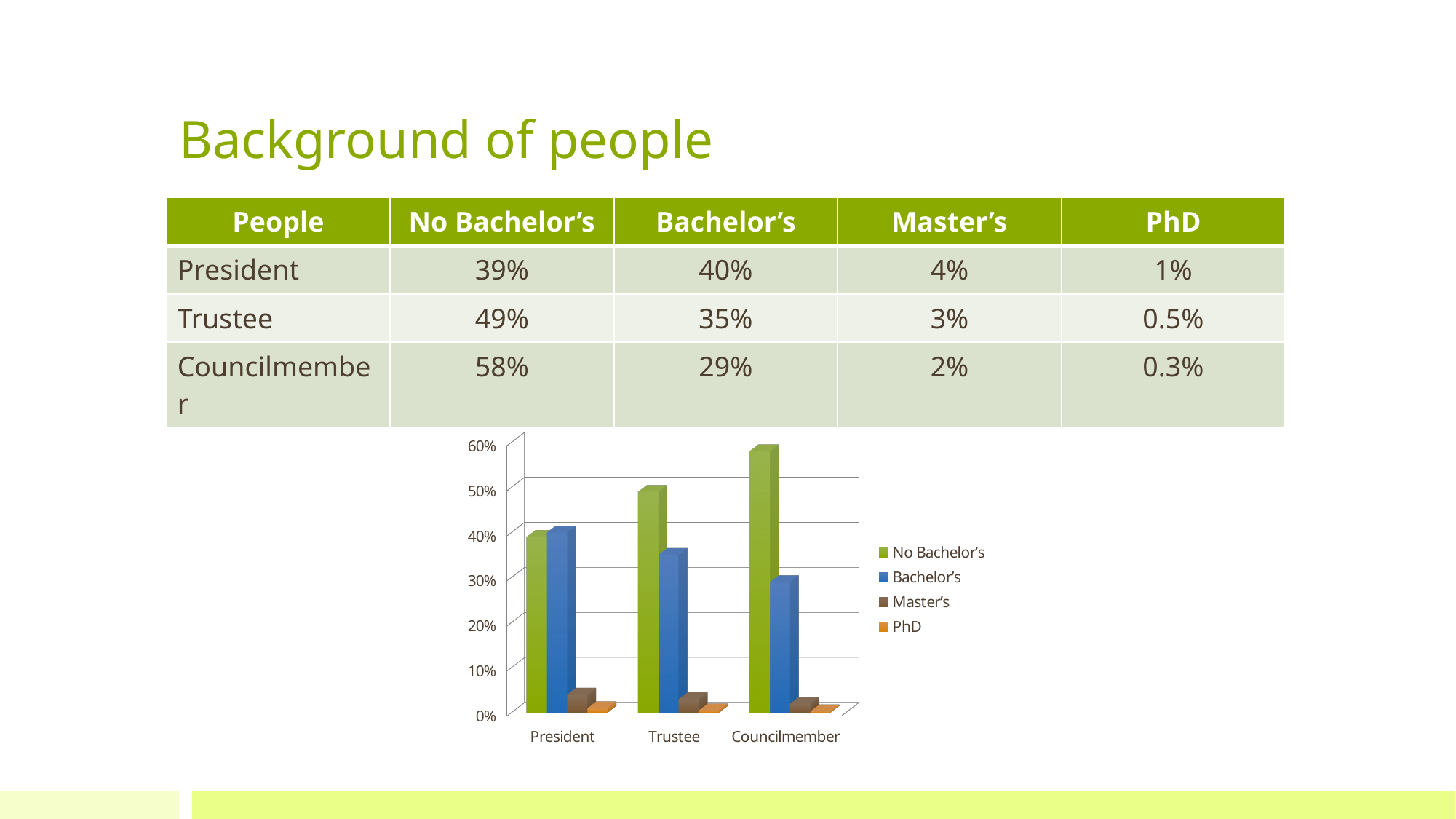
What is the Master's value for President? 4% How many categories are shown on the x axis of the chart? 3 What is the Bachelor's value for Trustee? 35% Which category has the highest No Bachelor's value? Councilmember Is the No Bachelor's value for Trustee greater or less than 40%? greater Which category has the lowest Bachelor's value? Councilmember How many series does the chart legend list? 4 Which is larger for Trustee, the No Bachelor's value or the Bachelor's value? No Bachelor's What is the difference between the No Bachelor's values for Councilmember and President? 19% Do the No Bachelor's values rise or fall from President to Councilmember along the x axis? rise What is the No Bachelor's value for Councilmember? 58% What kind of chart is shown on the slide? bar chart